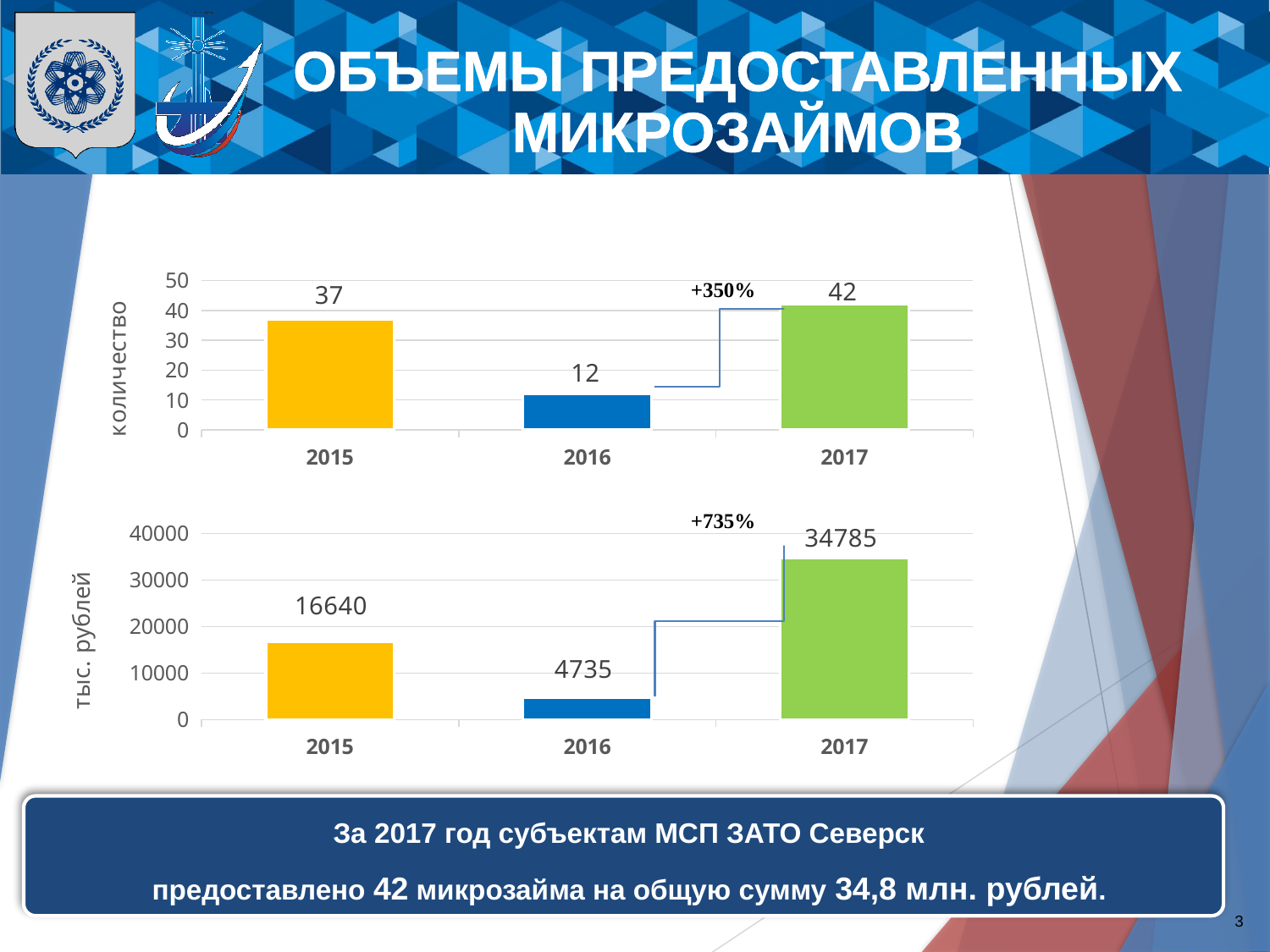
How many years are shown on the x axis of the top chart (количество)? 3 In the bottom chart (тыс. рублей), which year has the lowest value? 2016 In the top chart (количество), what is the value for 2016? 12 In the bottom chart (тыс. рублей), what is the value for 2015? 16640 In the bottom chart (тыс. рублей), what is the difference between the values for 2017 and 2015? 18145 In the top chart (количество), what is the difference between the values for 2017 and 2016? 30 In the top chart (количество), what is the value for 2017? 42 In the bottom chart (тыс. рублей), what is the value for 2017? 34785 In the bottom chart (тыс. рублей), which is larger, the value for 2015 or the value for 2016? 2015 In the top chart (количество), which year has the highest value? 2017 In the top chart (количество), what percentage change is annotated between 2016 and 2017? +350% What kind of chart is the bottom chart (тыс. рублей)? bar chart